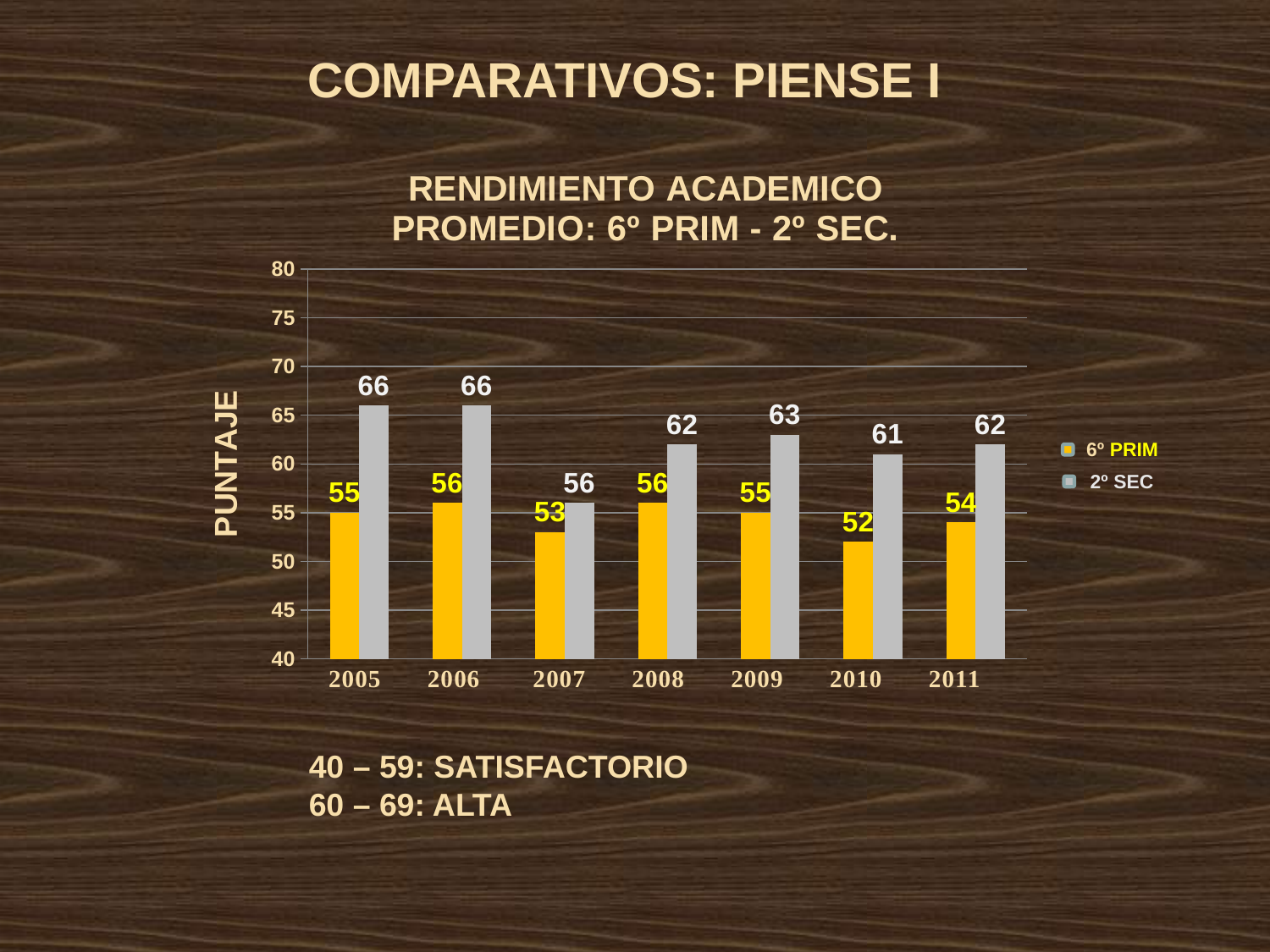
What kind of chart is shown on the slide? bar chart Which is larger, the 6º PRIM value in 2006 or the 6º PRIM value in 2007? 2006 Which year has the lowest value for 6º PRIM? 2010 How many years are shown on the x axis? 7 How many series does the legend list? 2 Which year has the lowest value for 2º SEC? 2007 What is the value for 6º PRIM in 2008? 56 What is the difference between the 2º SEC and 6º PRIM values in 2005? 11 Is the value for 2º SEC in 2010 greater or less than 60? greater What is the value for 2º SEC in 2009? 63 What is the label on the vertical axis of the chart? PUNTAJE What is the value for 6º PRIM in 2010? 52